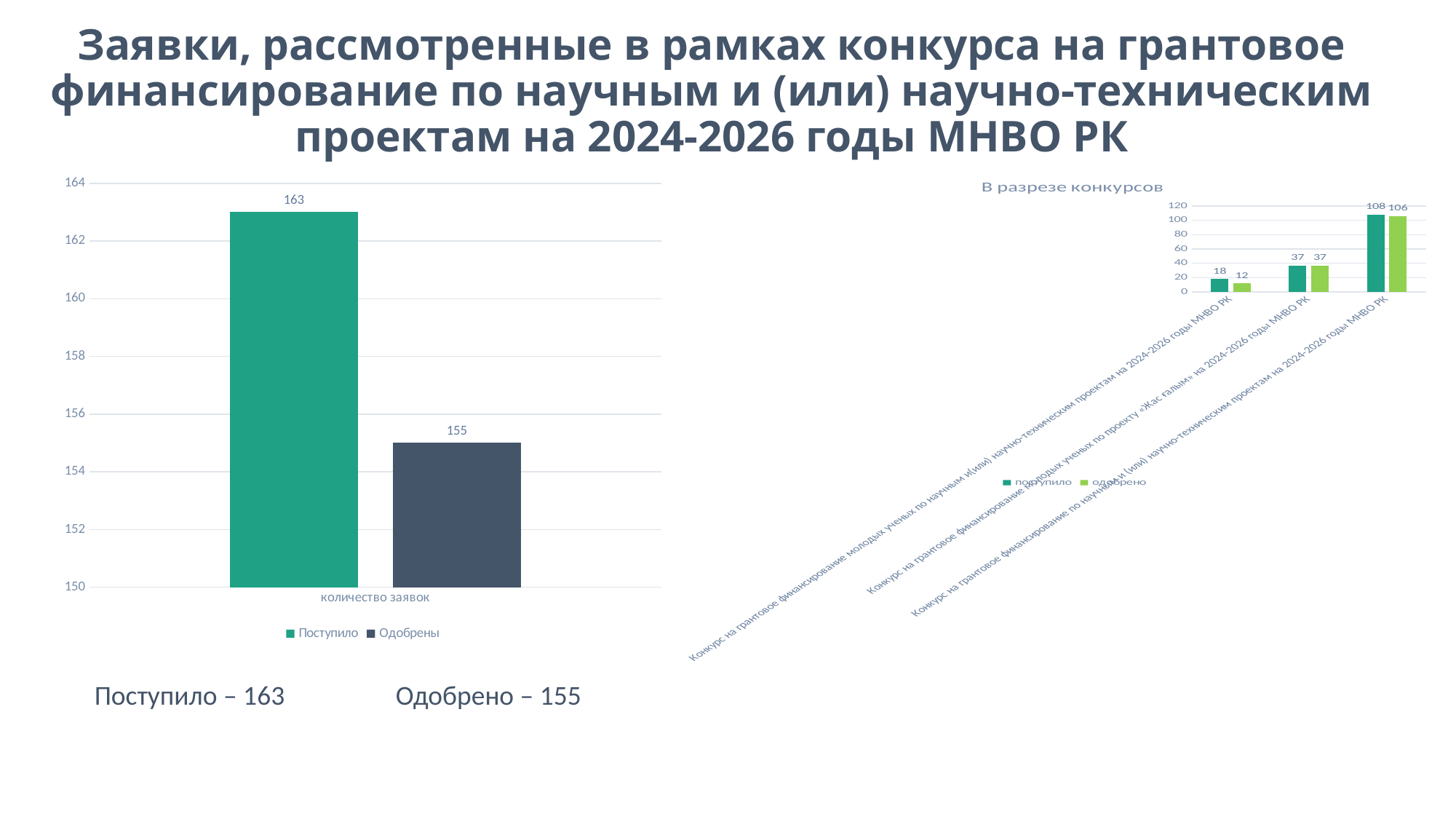
In the left chart, which is larger, Поступило or Одобрены? Поступило What is the title of the right chart? В разрезе конкурсов In the left chart, what is the value for Поступило? 163 In the chart titled 'В разрезе конкурсов', how many competitions (categories) are shown? 3 In the chart titled 'В разрезе конкурсов', what is the поступило value for the «Жас галым» competition? 37 In the chart titled 'В разрезе конкурсов', what is the difference between поступило and одобрено for the third (rightmost) competition? 2 In the chart titled 'В разрезе конкурсов', what is the одобрено value for the first (leftmost) competition? 12 In the left chart, what is the difference between Поступило and Одобрены? 8 In the left chart, what is the value for Одобрены? 155 In the chart titled 'В разрезе конкурсов', which competition has the highest поступило value? Конкурс на грантовое финансирование по научным и (или) научно-техническим проектам на 2024-2026 годы МНВО РК What kind of chart is the left chart? bar chart In the left chart, how many series does the legend list? 2